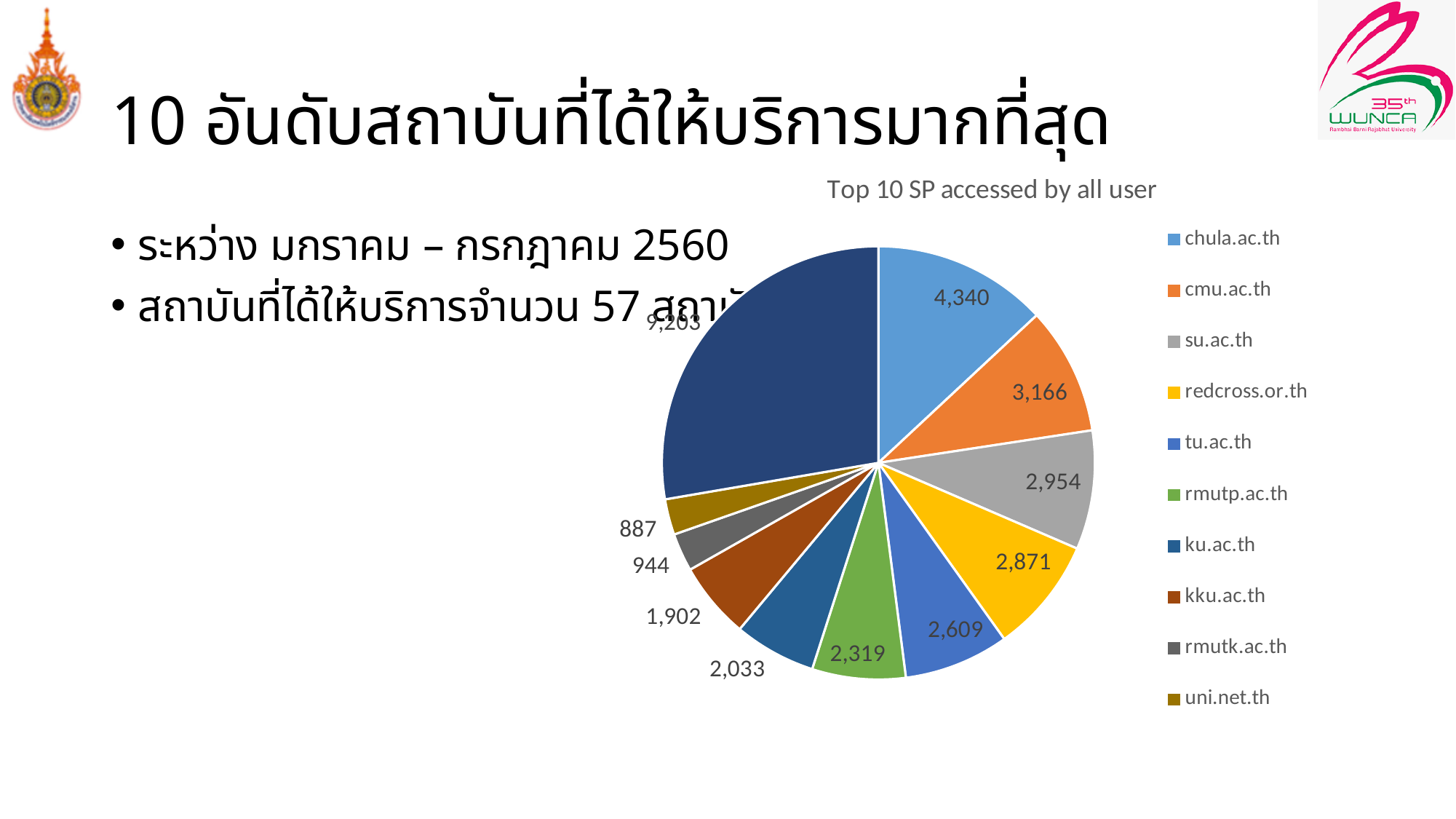
What is the value for kku.ac.th? 1,902 What type of chart is shown on the slide? pie chart How many entries does the legend list? 10 What is the value for rmutp.ac.th? 2,319 Which legend entry has the smallest value? uni.net.th What is the value for redcross.or.th? 2,871 What is the value for cmu.ac.th? 3,166 What is the title of the chart? Top 10 SP accessed by all user What is the value for chula.ac.th? 4,340 Which is larger, the value for kku.ac.th or rmutk.ac.th? kku.ac.th What is the difference between the values for chula.ac.th and cmu.ac.th? 1,174 What is the difference between the values for tu.ac.th and rmutp.ac.th? 290